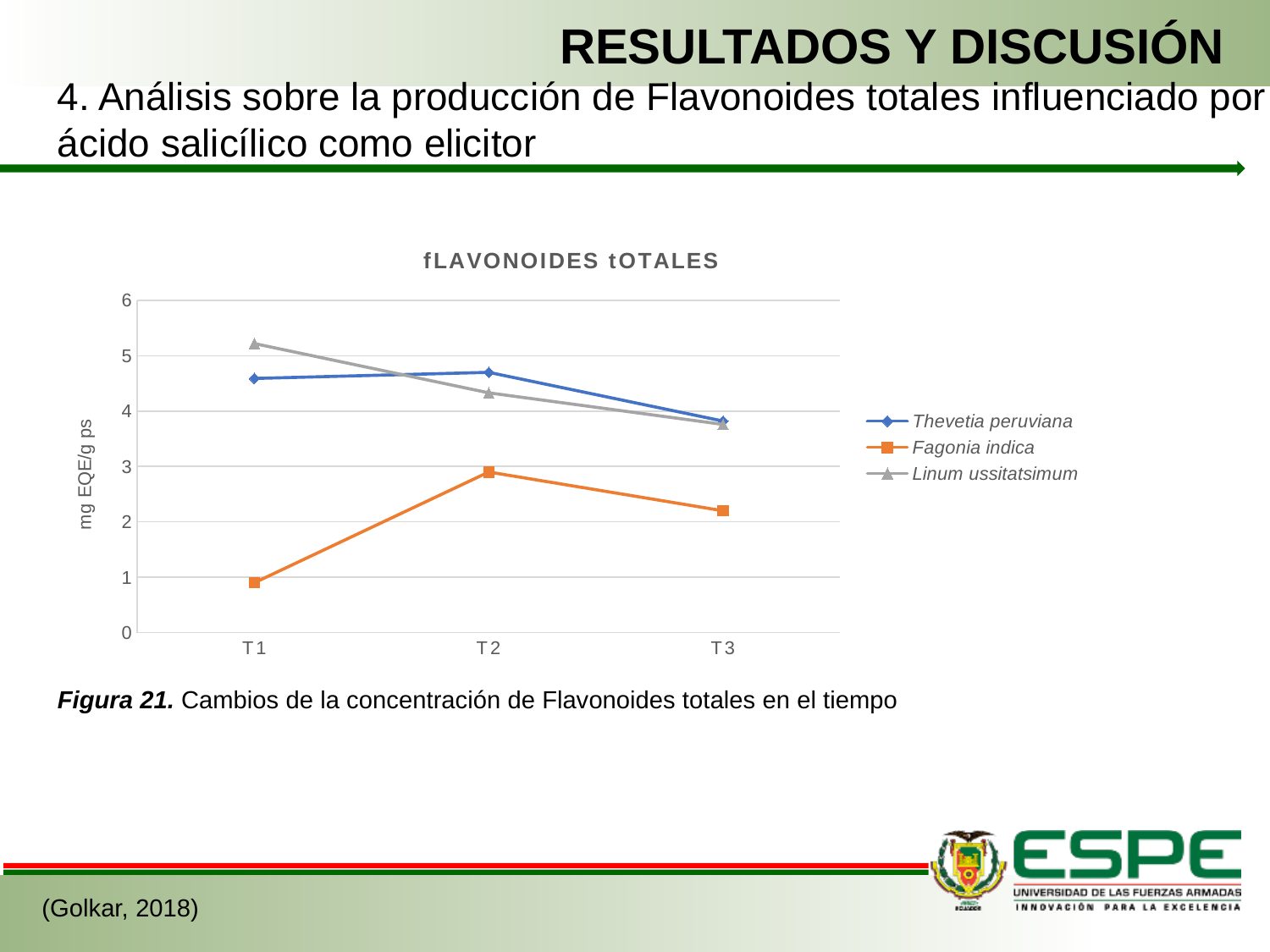
What type of chart is shown on the slide? Line chart How many time points are shown on the x axis? 3 Is the value for Linum ussitatsimum at T1 greater or less than 5? greater Which series has the highest value at T1? Linum ussitatsimum What is the label on the y axis of the chart? mg EQE/g ps At T2, which is larger: Thevetia peruviana or Linum ussitatsimum? Thevetia peruviana Which series has the lowest value at T1? Fagonia indica Is the value for Thevetia peruviana at T2 greater or less than 4? greater How many series does the legend list? 3 Does the value for Linum ussitatsimum rise or fall from T1 to T3? fall Which series has the lowest value at T3? Fagonia indica